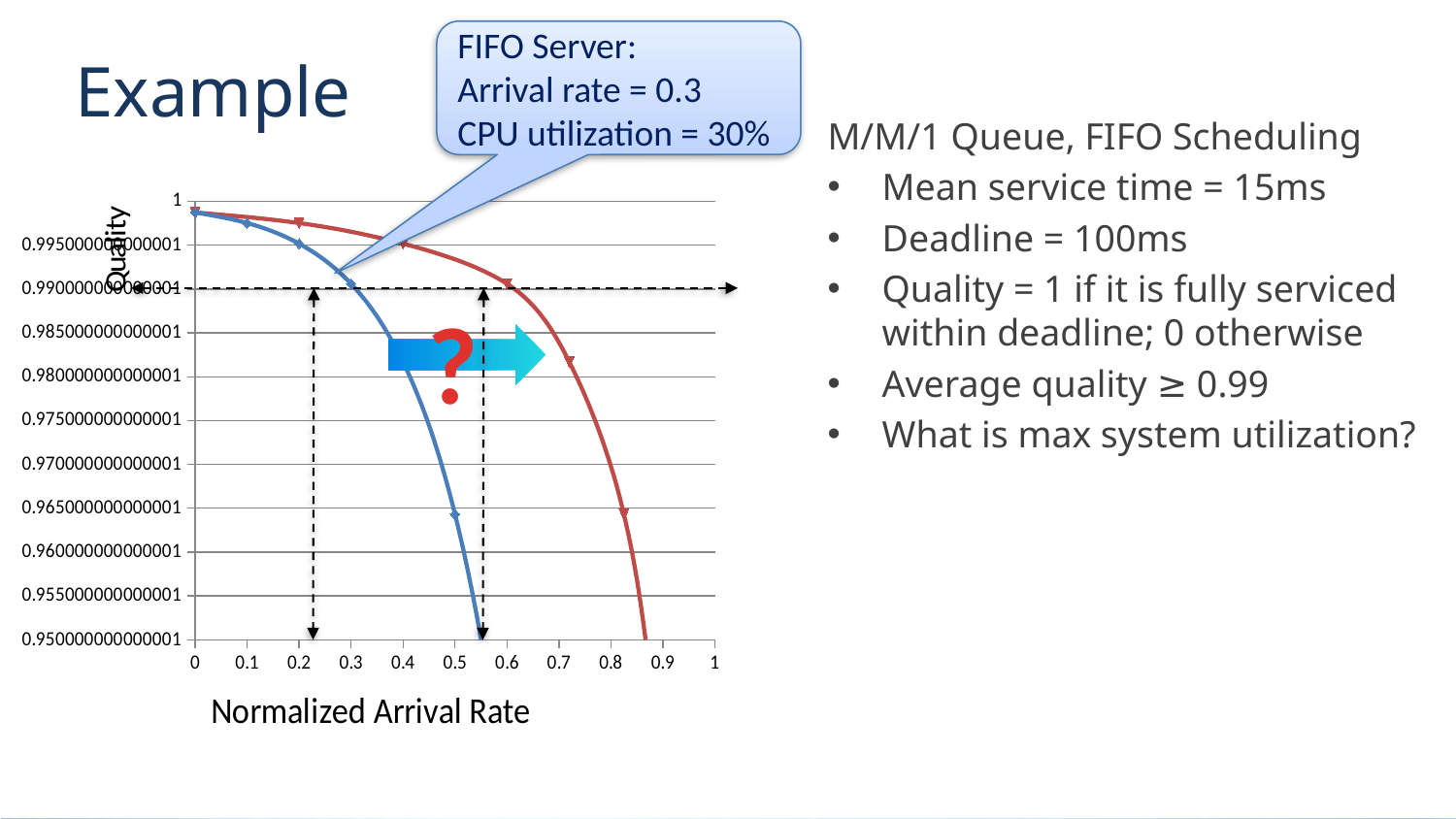
What kind of chart is shown on the slide? line chart At a normalized arrival rate of 0.5, which line is higher, the blue line or the red line? red line Is the value of the blue line at a normalized arrival rate of 0.5 greater or less than 0.97? less What is the highest value shown on the x axis of the chart? 1 What is the lowest value shown on the y axis of the chart? 0.950000000000001 Is the value of the blue line at a normalized arrival rate of 0.4 greater or less than 0.985? less How many lines are plotted on the chart? 2 Do the plotted quality values rise or fall as the normalized arrival rate increases? fall What is the title of the x axis of the chart? Normalized Arrival Rate What is the title of the y axis of the chart? Quality Is the value of the red line at a normalized arrival rate of 0.5 greater or less than 0.99? greater